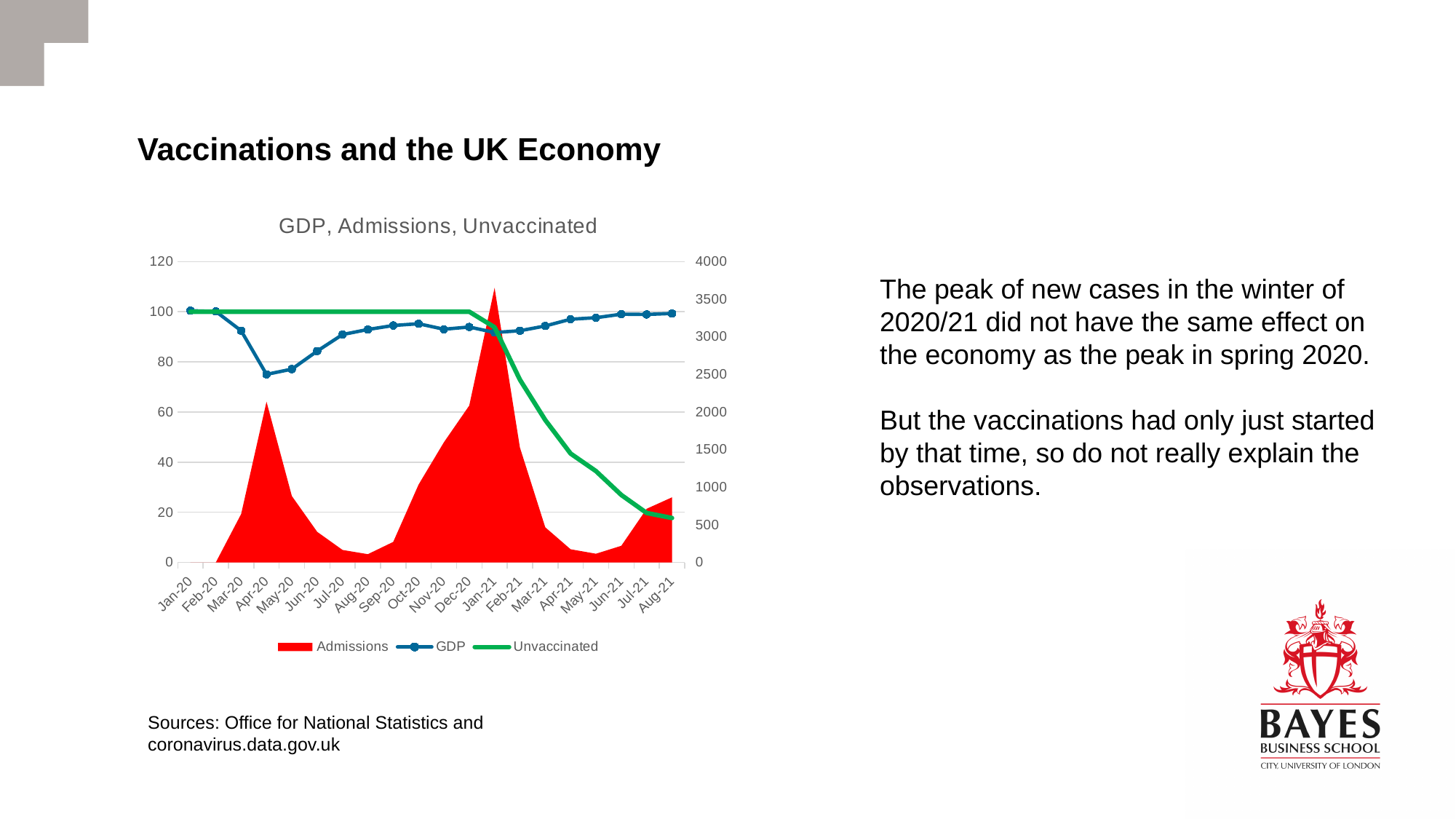
What colour represents Admissions in the chart? red Is the GDP value for Apr-20 greater or less than 80? less How many months are shown on the x axis of the chart? 20 Is the Unvaccinated value for Aug-21 greater or less than 1000 on the right axis? less What is the title of the chart? GDP, Admissions, Unvaccinated Is the Admissions value for Jan-21 greater or less than 100? greater Does the Unvaccinated series rise or fall from Jan-21 to Aug-21? fall In which month is GDP at its lowest? Apr-20 How many series does the chart legend list? 3 What kind of chart is used for the GDP series? line chart Which is larger, GDP in Apr-20 or GDP in Oct-20? Oct-20 In which month do Admissions reach their highest value? Jan-21